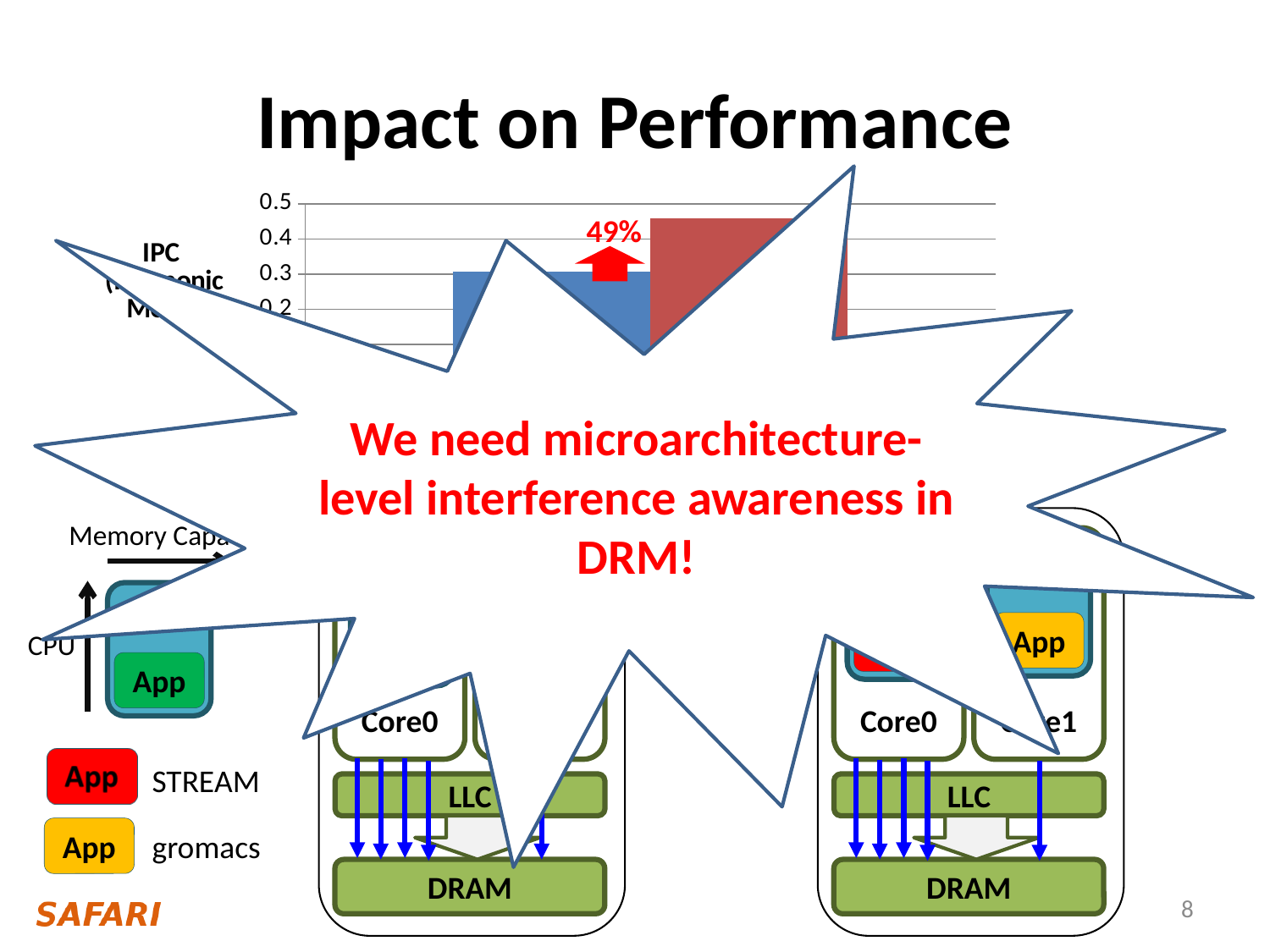
Is the value of the red bar in the chart greater or less than 0.4? greater What kind of chart is shown at the top of the slide? bar chart Is the value of the blue bar in the chart greater or less than 0.4? less Which bar in the chart is taller, the red bar or the blue bar? the red bar What percentage improvement is annotated above the bars in the chart? 49% What is the highest value shown on the chart's y axis? 0.5